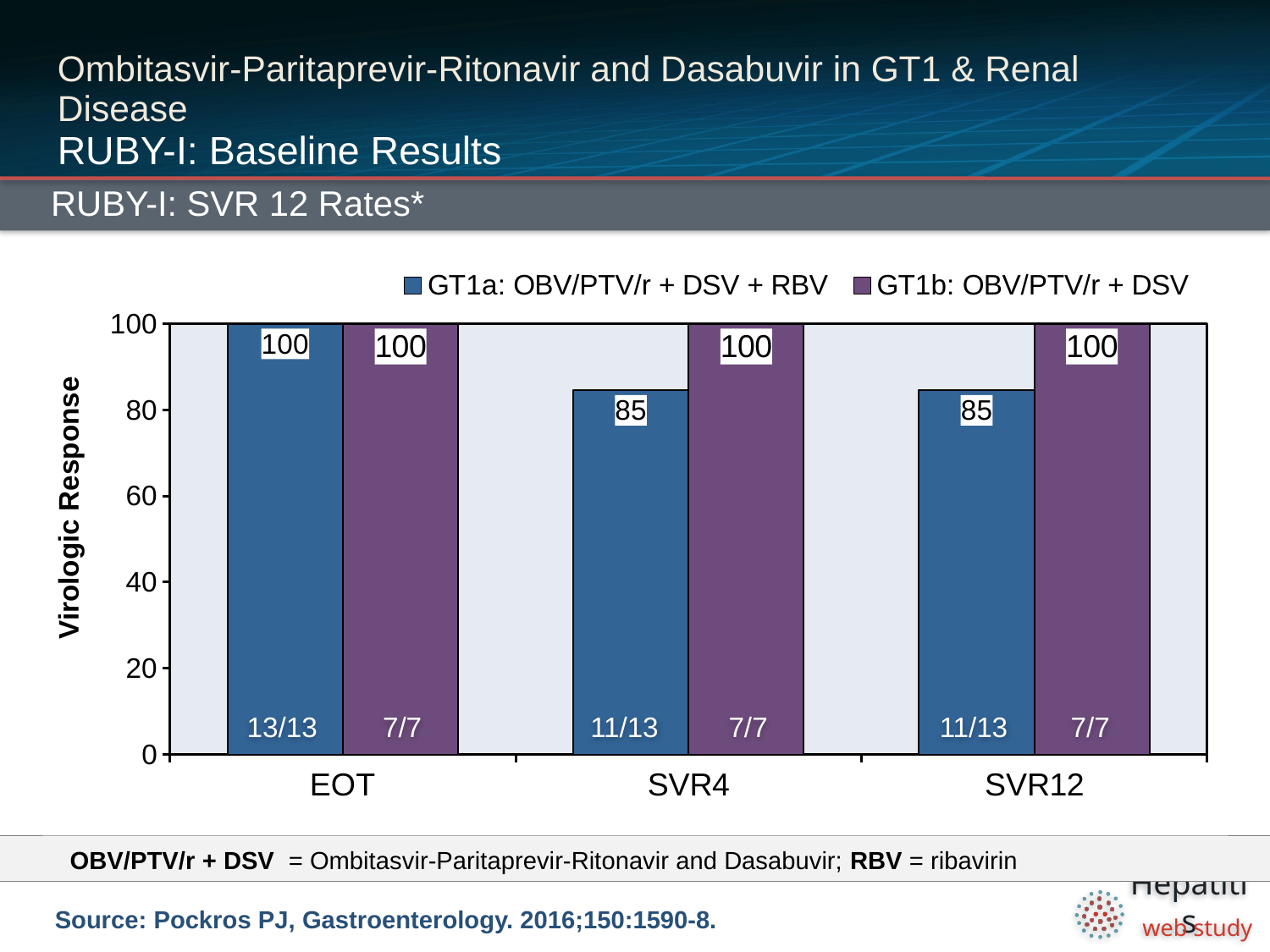
How many series does the legend list? 2 At SVR4, which series has the larger value, GT1a: OBV/PTV/r + DSV + RBV or GT1b: OBV/PTV/r + DSV? GT1b: OBV/PTV/r + DSV What is the label of the y axis? Virologic Response At which time point is the GT1a: OBV/PTV/r + DSV + RBV value highest? EOT What fraction of patients is shown inside the GT1a: OBV/PTV/r + DSV + RBV bar at SVR4? 11/13 What is the difference between the GT1b: OBV/PTV/r + DSV and GT1a: OBV/PTV/r + DSV + RBV values at SVR12? 15 What is the value for GT1b: OBV/PTV/r + DSV at SVR4? 100 What is the value for GT1a: OBV/PTV/r + DSV + RBV at SVR12? 85 How many time points are shown on the x axis? 3 What kind of chart is shown on the slide? Bar chart What is the value for GT1a: OBV/PTV/r + DSV + RBV at EOT? 100 What fraction of patients is shown inside the GT1b: OBV/PTV/r + DSV bar at EOT? 7/7